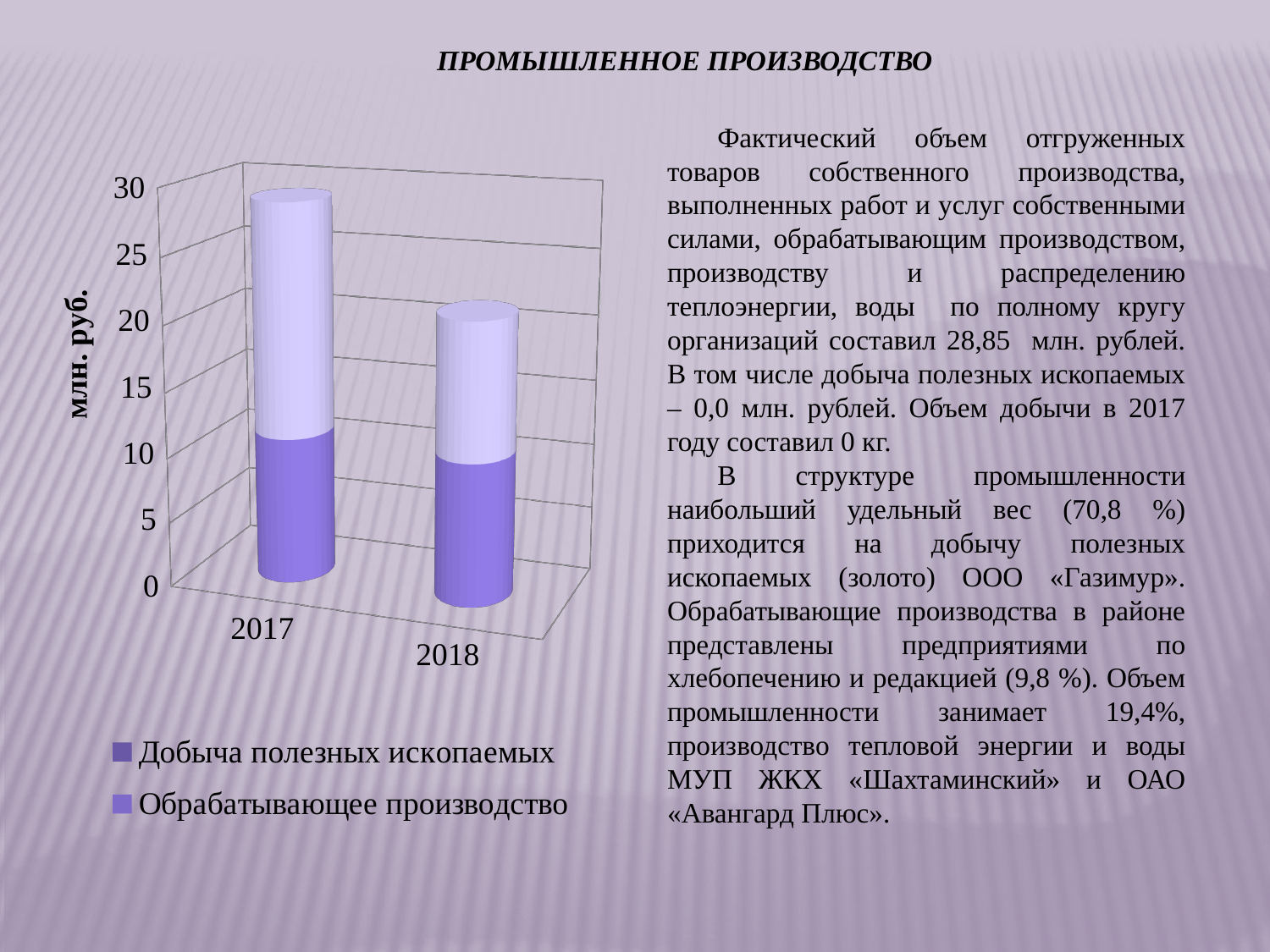
Which year has the taller stacked bar, 2017 or 2018? 2017 Is the total value of the stacked bar for 2017 greater or less than 25? greater Do the stacked bar totals rise or fall from 2017 to 2018? fall What is the title of the vertical axis of the chart? млн. руб. Is the value of 'Добыча полезных ископаемых' for 2017 greater or less than 5? less Is the total value of the stacked bar for 2018 greater or less than 25? less How many series does the chart legend list? 2 What kind of chart is shown on the slide? bar chart Which series is shown in the darker purple colour in the chart legend? Добыча полезных ископаемых How many years are shown on the x axis of the chart? 2